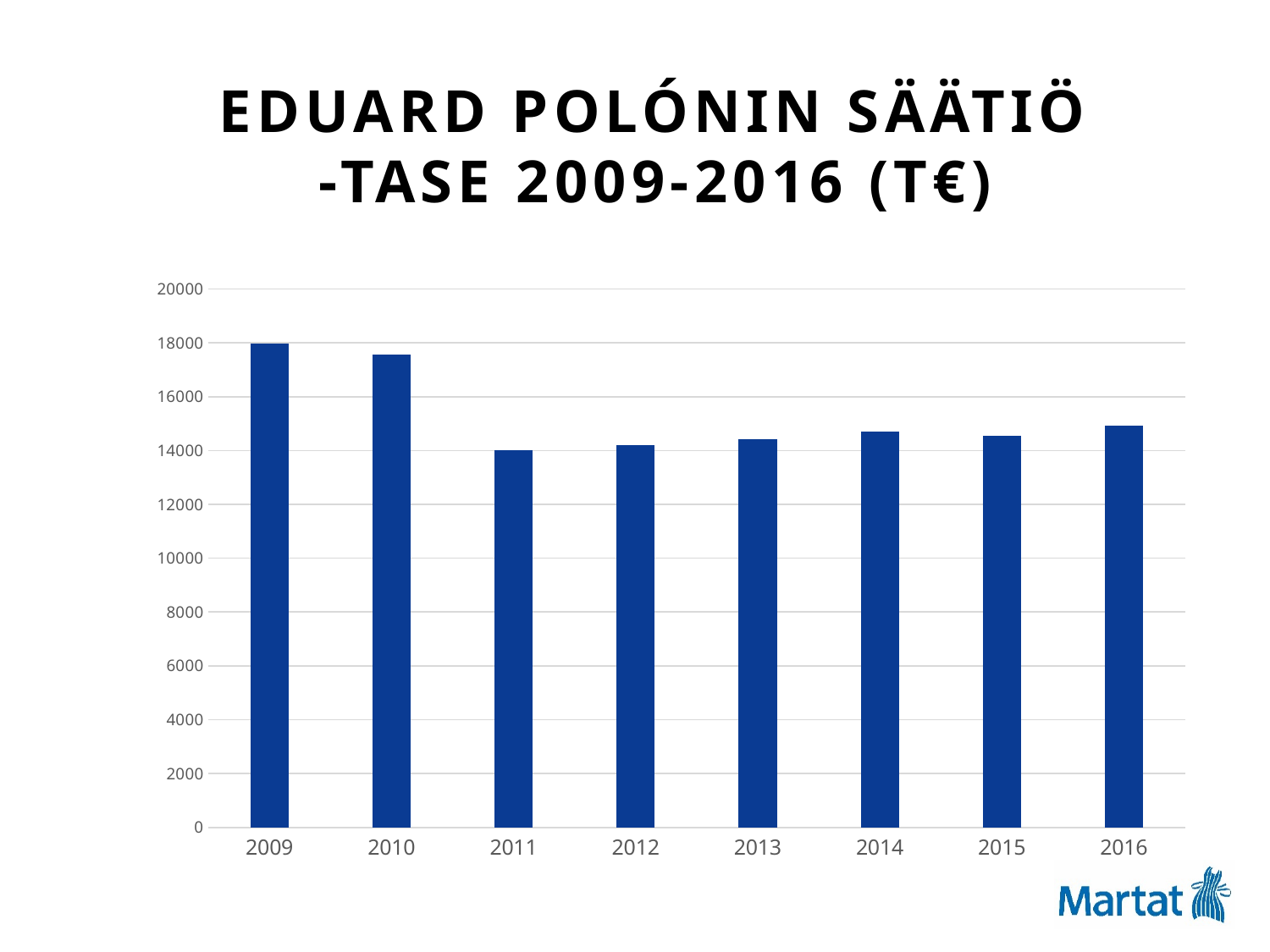
Is the value for 2009 greater or less than 16000? greater Which year has the highest value in the chart? 2009 How many years are shown on the x axis of the chart? 8 Which is larger, the value for 2009 or the value for 2011? 2009 Overall, do the values rise or fall from 2009 to 2016? fall What kind of chart is shown on the slide? bar chart Which is larger, the value for 2010 or the value for 2016? 2010 Is the value for 2010 greater or less than 16000? greater Is the value for 2014 greater or less than 16000? less What is the title of the chart on the slide? EDUARD POLÓNIN SÄÄTIÖ -TASE 2009-2016 (T€)